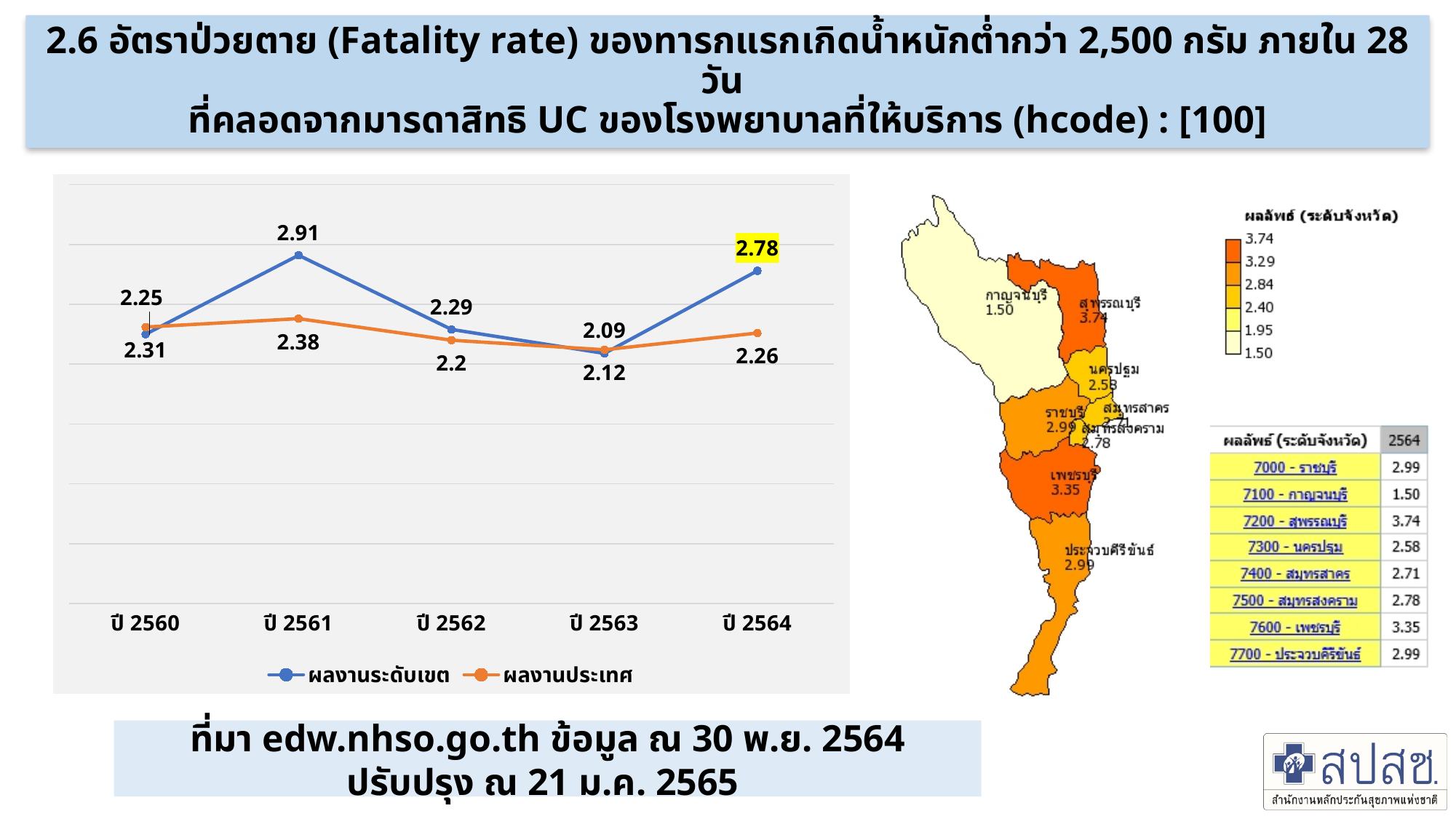
What is the value of ผลงานระดับเขต in ปี 2561? 2.91 In which year is ผลงานระดับเขต lowest? ปี 2563 What is the value of ผลงานระดับเขต in ปี 2564? 2.78 In ปี 2564, which series has the larger value, ผลงานระดับเขต or ผลงานประเทศ? ผลงานระดับเขต What are the two series named in the legend of the line chart? ผลงานระดับเขต and ผลงานประเทศ How many years are plotted along the x axis of the line chart? 5 What is the difference between ผลงานระดับเขต and ผลงานประเทศ in ปี 2561? 0.53 What type of chart is shown on the left of the slide? line chart How many series does the legend of the line chart list? 2 What is the value of ผลงานประเทศ in ปี 2564? 2.26 In which year is ผลงานระดับเขต highest? ปี 2561 What is the value of ผลงานประเทศ in ปี 2562? 2.2